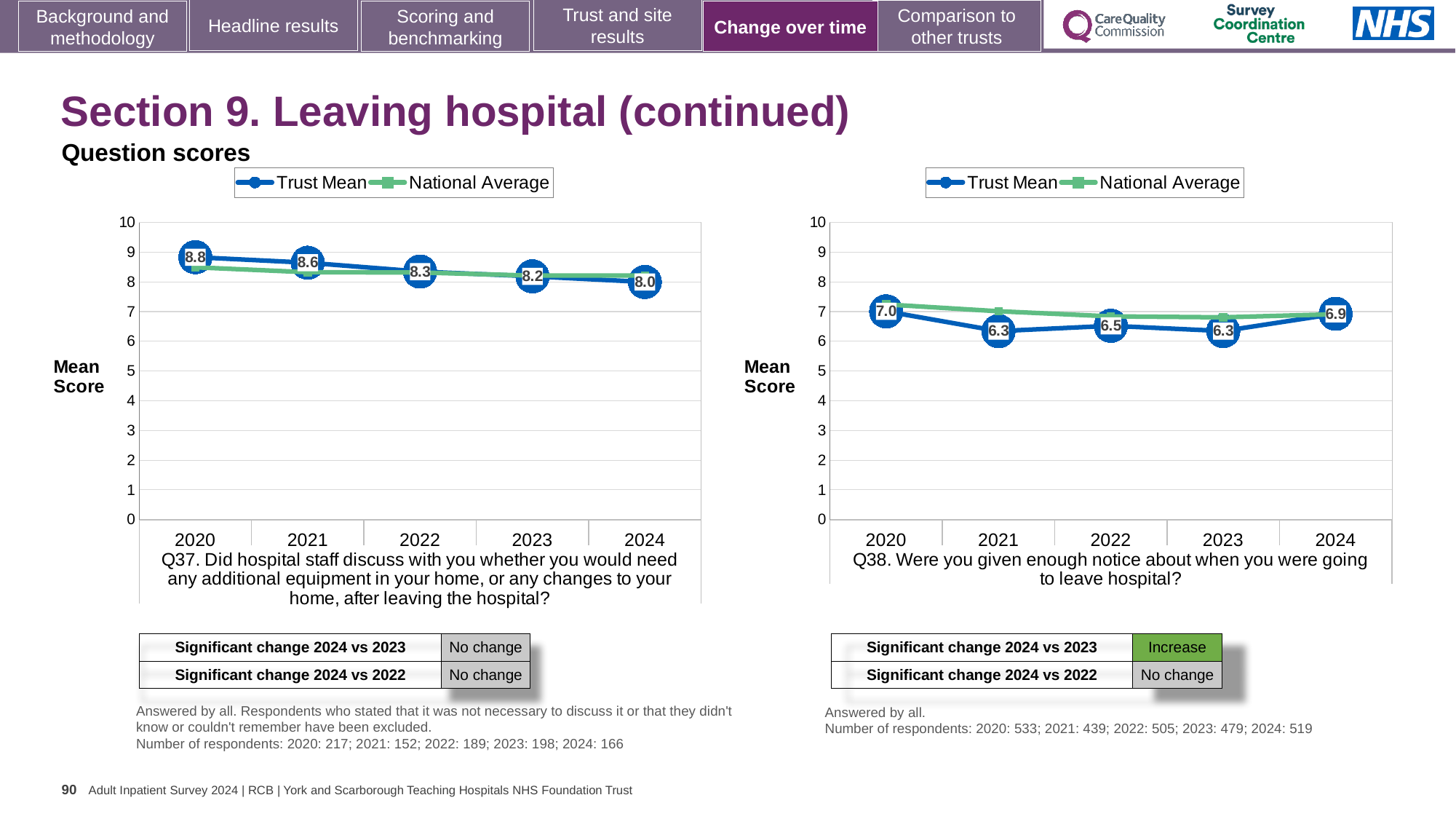
In the Q37 chart (left), which year has the highest Trust Mean score? 2020 In the Q38 chart (right), what is the Trust Mean score for 2021? 6.3 In the Q38 chart (right), is the Trust Mean score for 2022 higher or lower than for 2024? lower What kind of chart is the Q37 chart (left)? line chart How many series does the legend of the Q38 chart (right) list? 2 In the Q37 chart (left), what is the difference between the Trust Mean scores for 2020 and 2024? 0.8 In the Q37 chart (left), is the National Average for 2020 greater or less than 8? greater In the Q37 chart (left), what is the Trust Mean score for 2024? 8.0 In the Q38 chart (right), what is the difference between the Trust Mean scores for 2024 and 2023? 0.6 In the Q38 chart (right), which year has the highest Trust Mean score? 2020 In the Q38 chart (right), what is the Trust Mean score for 2024? 6.9 In the Q37 chart (left), what is the Trust Mean score for 2020? 8.8